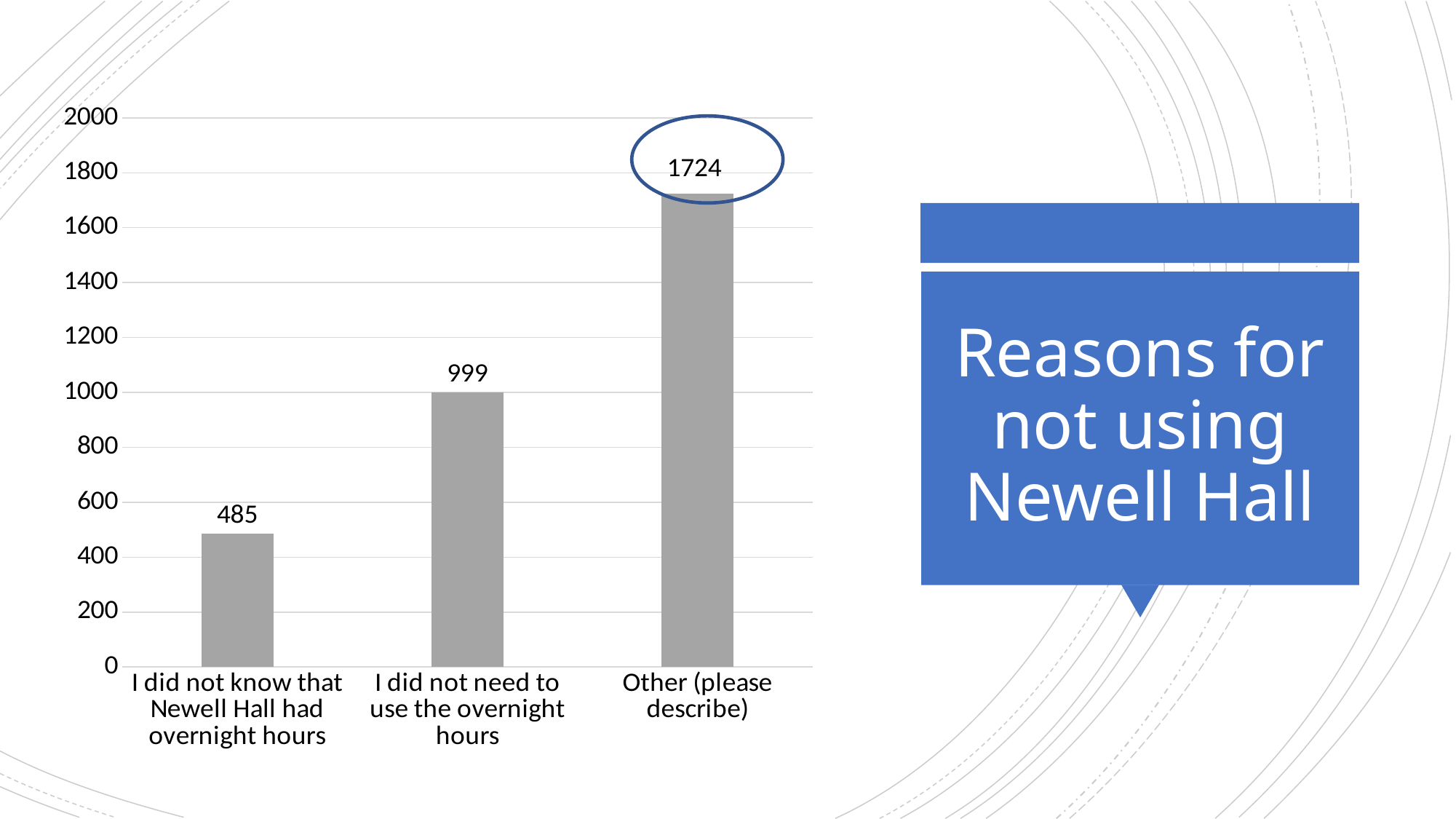
What is the difference between the values for "Other (please describe)" and "I did not need to use the overnight hours"? 725 Is the value for "Other (please describe)" greater or less than 1600? greater What is the value for "Other (please describe)"? 1724 What is the difference between the values for "I did not need to use the overnight hours" and "I did not know that Newell Hall had overnight hours"? 514 What is the value for "I did not need to use the overnight hours"? 999 What kind of chart is shown on the slide? bar chart Do the values rise or fall from left to right across the categories? rise How many categories are shown in the chart? 3 What is the value for "I did not know that Newell Hall had overnight hours"? 485 Which category has the lowest value? I did not know that Newell Hall had overnight hours Which is larger: the value for "I did not need to use the overnight hours" or the value for "I did not know that Newell Hall had overnight hours"? I did not need to use the overnight hours Which category has the highest value? Other (please describe)